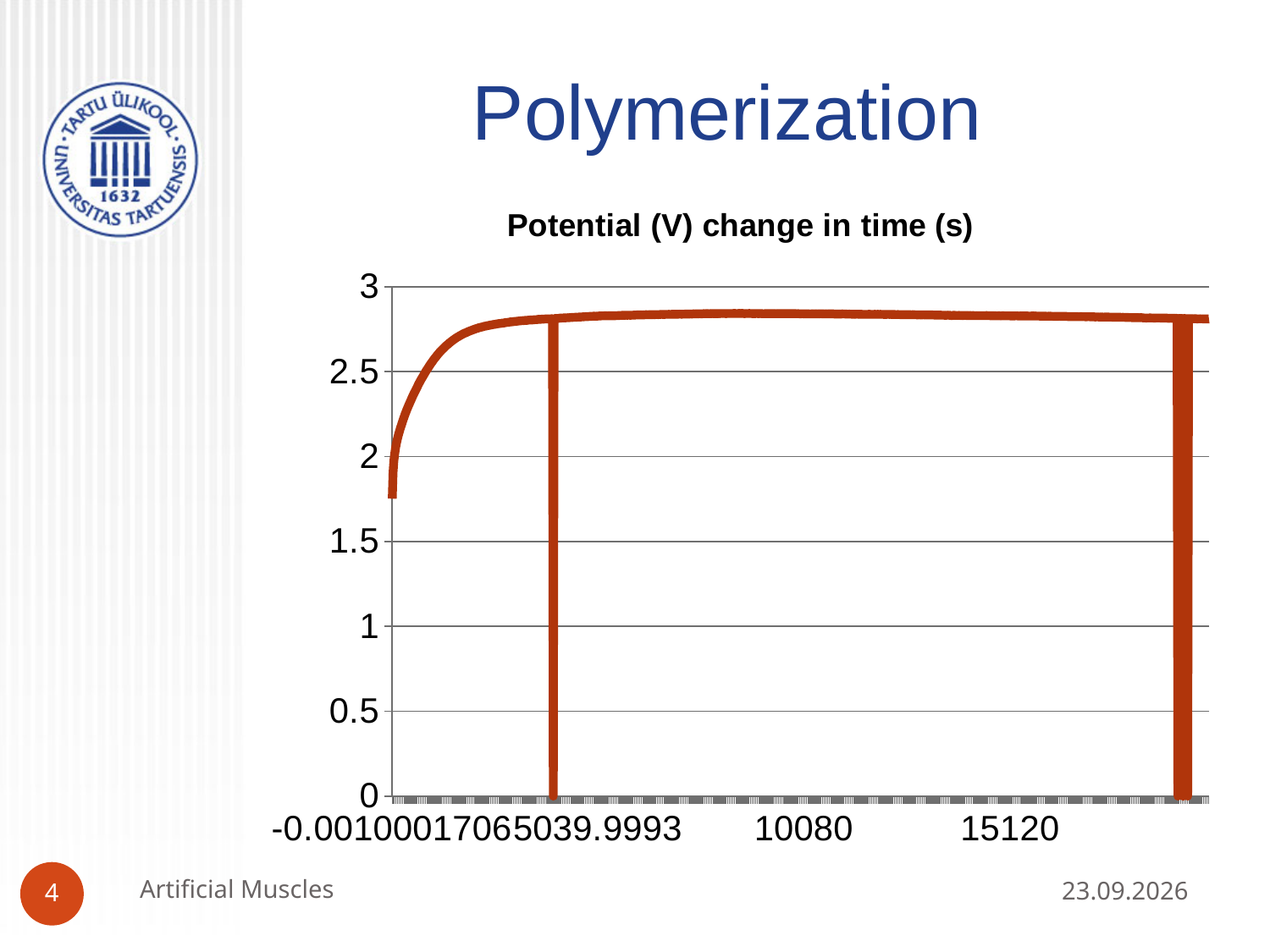
Does the plotted potential rise or fall over the first part of the time axis, before it levels off? rise What is the step between consecutive labelled ticks on the vertical axis? 0.5 Is the plotted potential at time 10080 greater or less than 3? less What kind of chart is shown on the slide? line chart Is the plotted potential at time 15120 greater or less than 2? greater Is the plotted potential at the very start of the curve greater or less than 2? less What is the highest value labelled on the vertical axis of the chart? 3 What is the title of the chart? Potential (V) change in time (s) Is the potential at time 10080 larger or smaller than the potential at the very start of the curve? larger